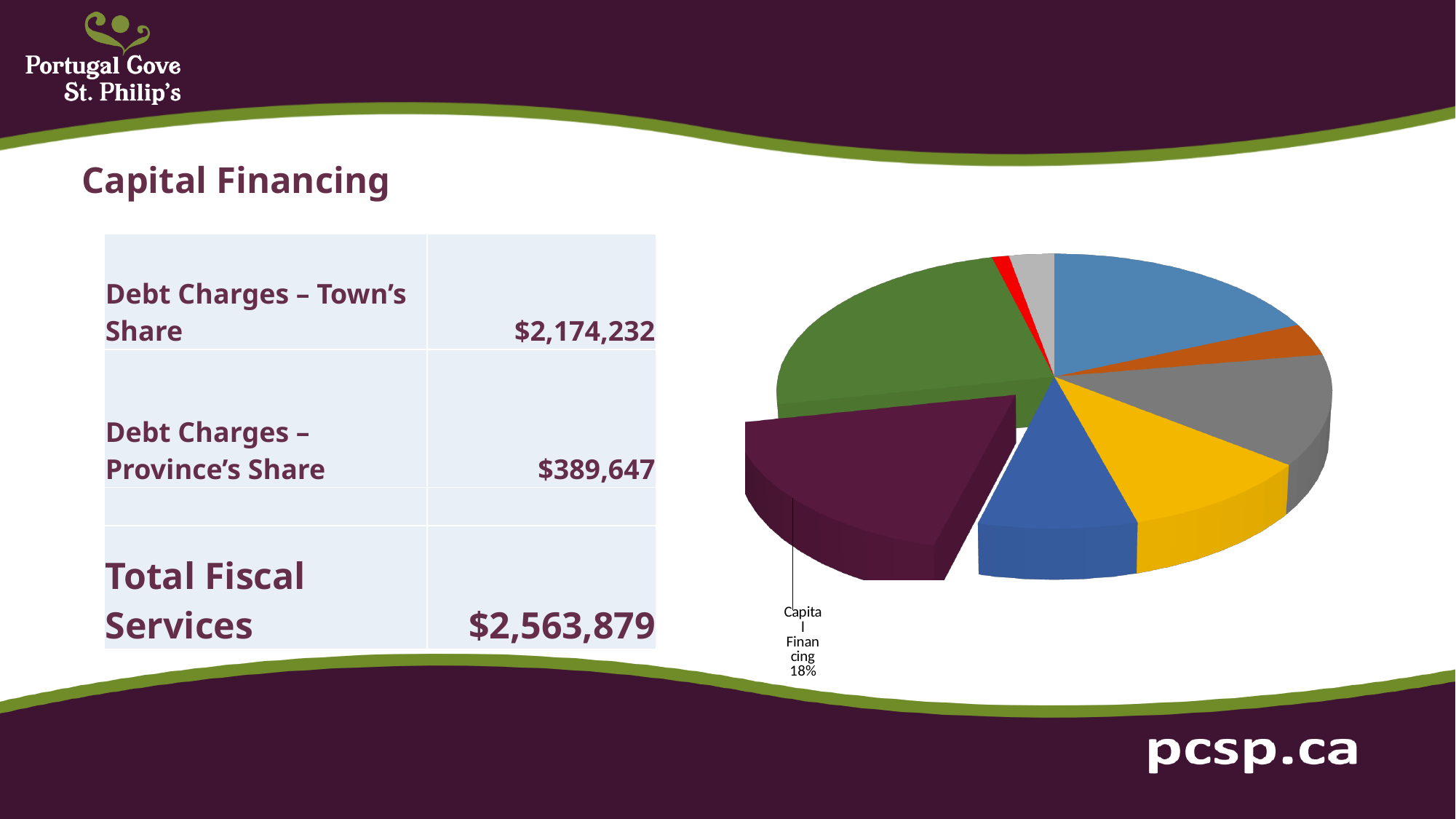
What share of the pie does the Capital Financing slice represent? 18% Which slice of the pie chart is labelled with a percentage? Capital Financing Is the share for Capital Financing greater or less than 25%? less How many slices does the pie chart have? 9 What kind of chart is shown on the slide? pie chart Which slice of the pie chart is pulled out (exploded) from the rest of the pie? Capital Financing